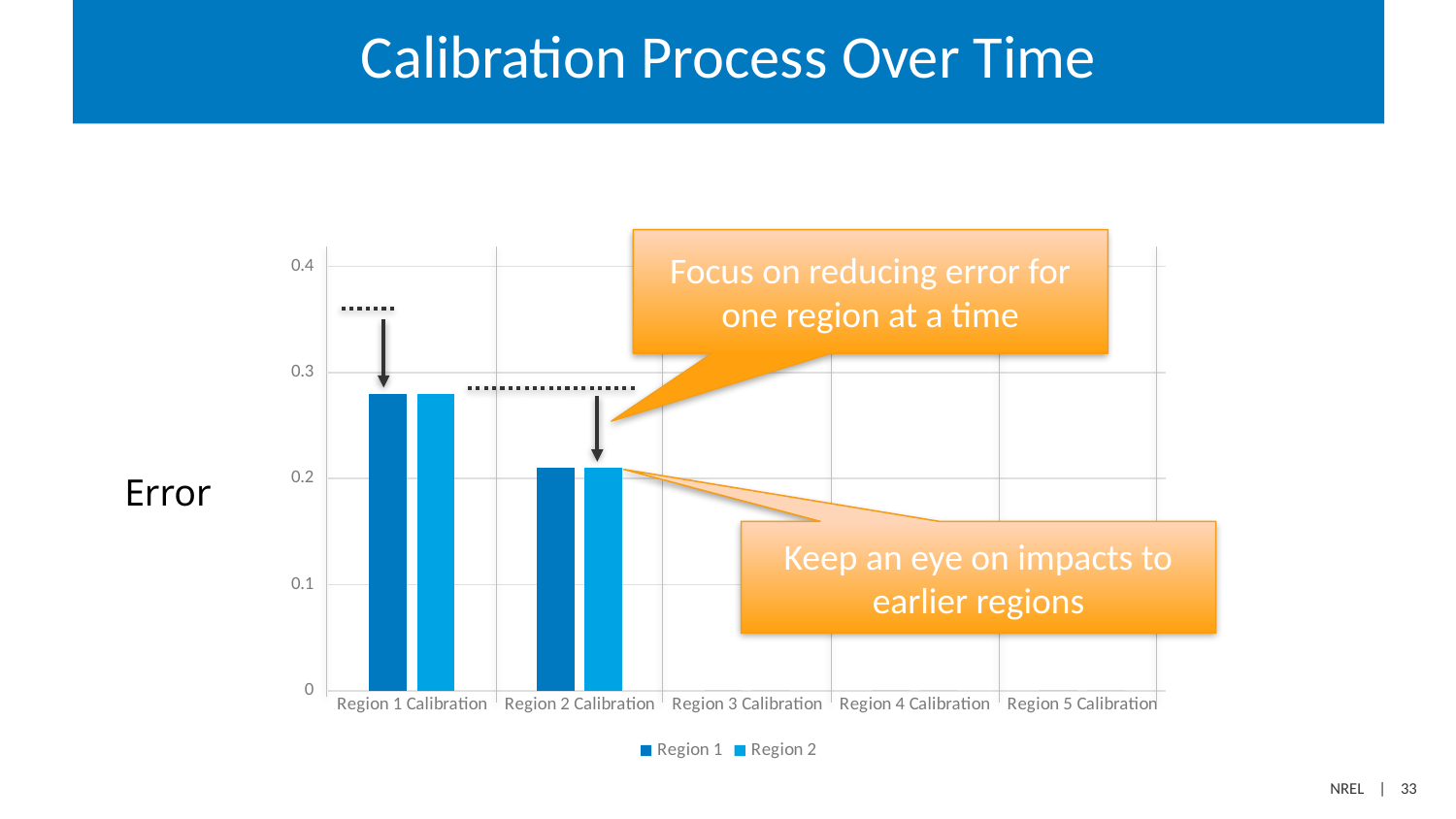
Is the Region 1 value for Region 1 Calibration greater or less than 0.3? less Do the Region 2 series values rise or fall from Region 1 Calibration to Region 2 Calibration? fall Is the Region 2 value for Region 1 Calibration greater or less than 0.2? greater Is the Region 1 value for Region 2 Calibration greater or less than 0.1? greater How many series does the chart legend list? 2 What are the two series listed in the chart legend? Region 1 and Region 2 How many categories are shown on the x axis of the chart? 5 What kind of chart is shown on the slide? bar chart For the Region 1 series, which is larger: the value at Region 1 Calibration or at Region 2 Calibration? Region 1 Calibration What is the label shown on the vertical axis of the chart? Error